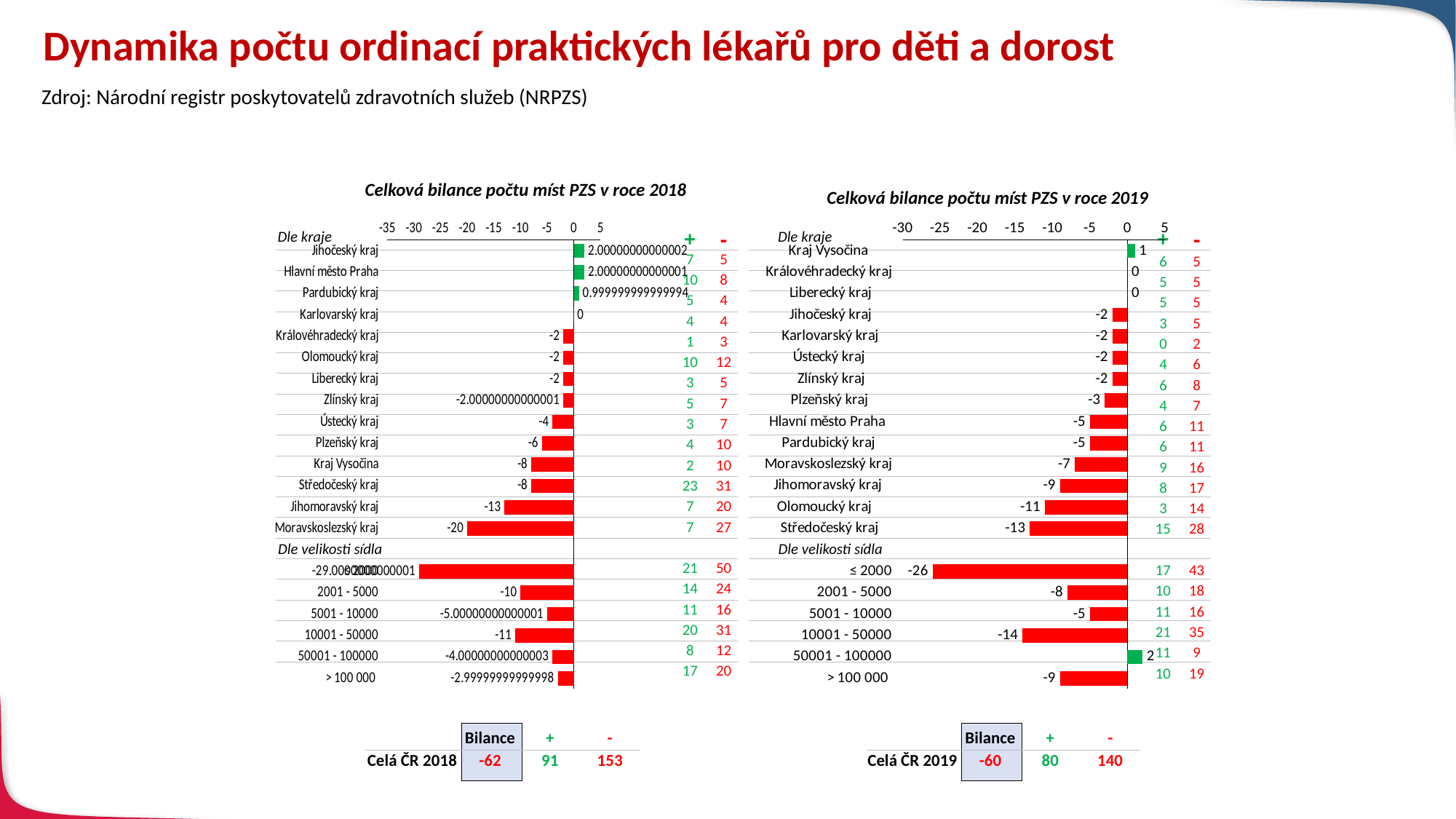
In the 'Celková bilance počtu míst PZS v roce 2019' chart, what is the value for the '≤ 2000' settlement size category? -26 What type of chart is 'Celková bilance počtu míst PZS v roce 2019'? Bar chart In the 'Celková bilance počtu míst PZS v roce 2019' chart, what is the value for the '50001 - 100000' settlement size category? 2 In the 'Celková bilance počtu míst PZS v roce 2018' chart, which region (kraj) has the lowest value? Moravskoslezský kraj In the 'Celková bilance počtu míst PZS v roce 2019' chart, which category has the lowest value? ≤ 2000 In the 'Celková bilance počtu míst PZS v roce 2019' chart, what is the difference between the values for Olomoucký kraj and Středočeský kraj? 2 What is the title of the left chart on the slide? Celková bilance počtu míst PZS v roce 2018 In the 'Celková bilance počtu míst PZS v roce 2019' chart, what is the value for Středočeský kraj? -13 In the 'Celková bilance počtu míst PZS v roce 2019' chart, how many regions (kraje) are listed under 'Dle kraje'? 14 In the 'Celková bilance počtu míst PZS v roce 2018' chart, which has the larger value, Jihomoravský kraj or Moravskoslezský kraj? Jihomoravský kraj In the 'Celková bilance počtu míst PZS v roce 2018' chart, what is the value for Moravskoslezský kraj? -20 In the 'Celková bilance počtu míst PZS v roce 2018' chart, what is the value for Jihomoravský kraj? -13